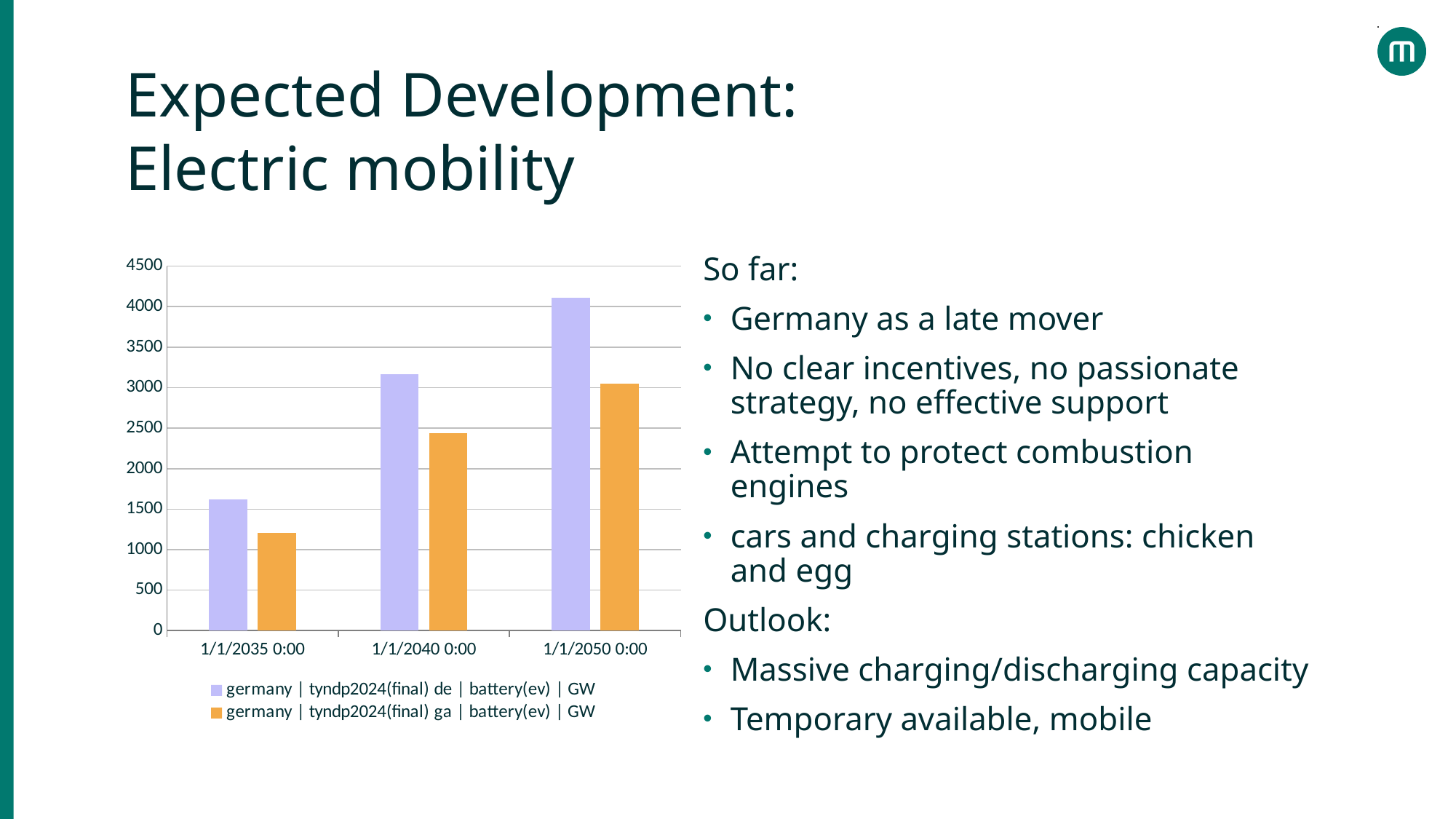
Is the value for the 'de' series at 1/1/2035 0:00 greater or less than 1500? greater What colour are the bars for the series 'germany | tyndp2024(final) ga | battery(ev) | GW'? orange At 1/1/2040 0:00, which series has the larger value: 'de' or 'ga'? germany | tyndp2024(final) de | battery(ev) | GW Which date has the highest value for the series 'germany | tyndp2024(final) de | battery(ev) | GW'? 1/1/2050 0:00 How many date categories are shown on the x axis of the chart? 3 Is the value for the 'ga' series at 1/1/2035 0:00 greater or less than 1500? less What kind of chart is shown on the slide? bar chart Which date has the lowest value for the series 'germany | tyndp2024(final) ga | battery(ev) | GW'? 1/1/2035 0:00 Is the value for the 'de' series at 1/1/2050 0:00 greater or less than 4000? greater How many series does the chart legend list? 2 Do the values of the 'de' series rise or fall from 1/1/2035 0:00 to 1/1/2050 0:00? rise